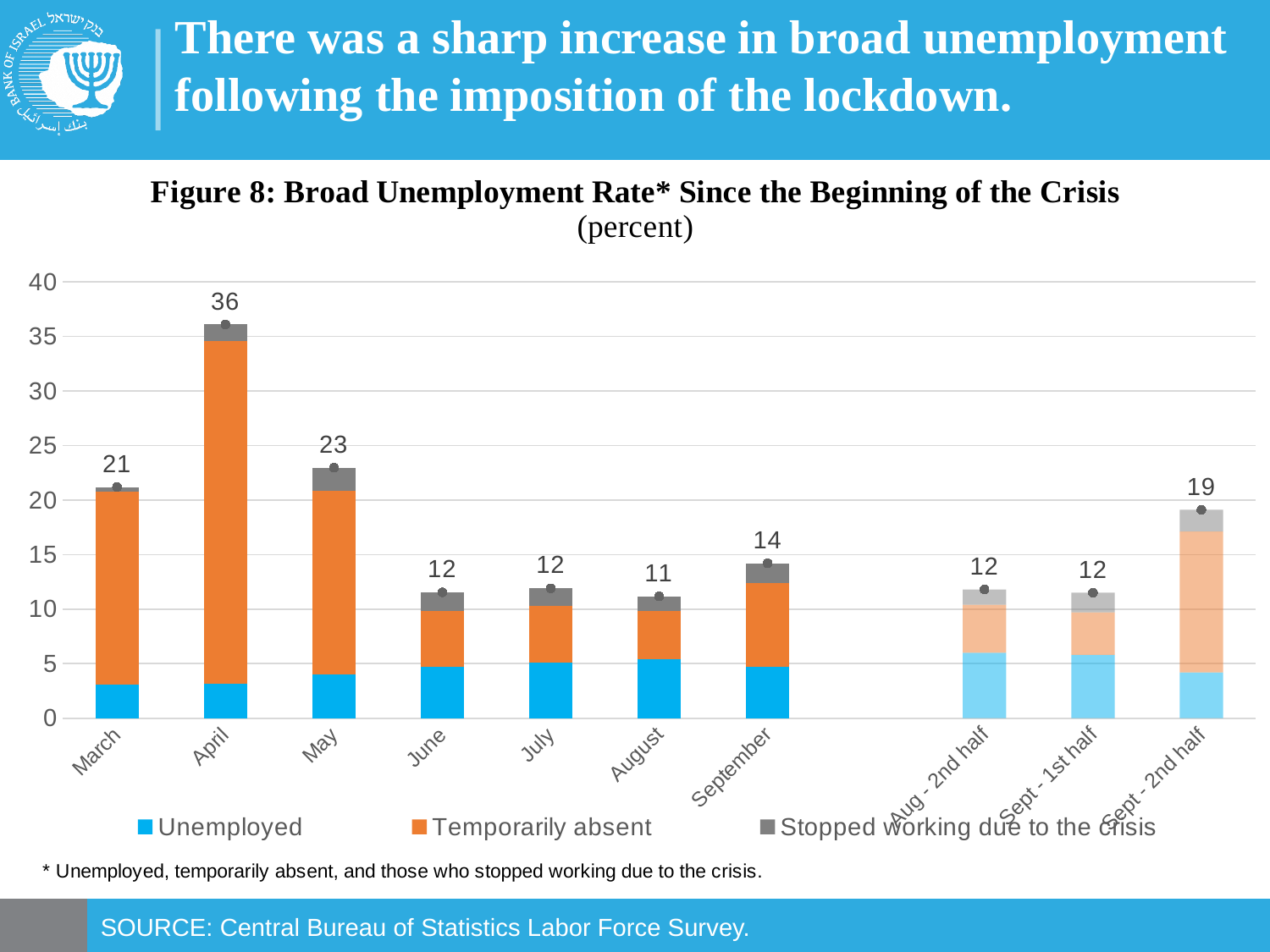
Which period has the highest total broad unemployment rate? April Which is larger, the total for March or the total for September? March Which period has the lowest total broad unemployment rate? August What kind of chart is shown? Stacked bar chart How many periods (bars) are shown on the x axis? 10 What is the total broad unemployment rate shown for April? 36 What is the difference between the total for April and the total for May? 13 What is the total broad unemployment rate shown for Sept - 2nd half? 19 Which series is shown in orange in the legend? Temporarily absent How many series does the legend list? 3 What is the difference between the total for Sept - 2nd half and the total for Sept - 1st half? 7 Is the Unemployed segment for March greater or less than 5? less